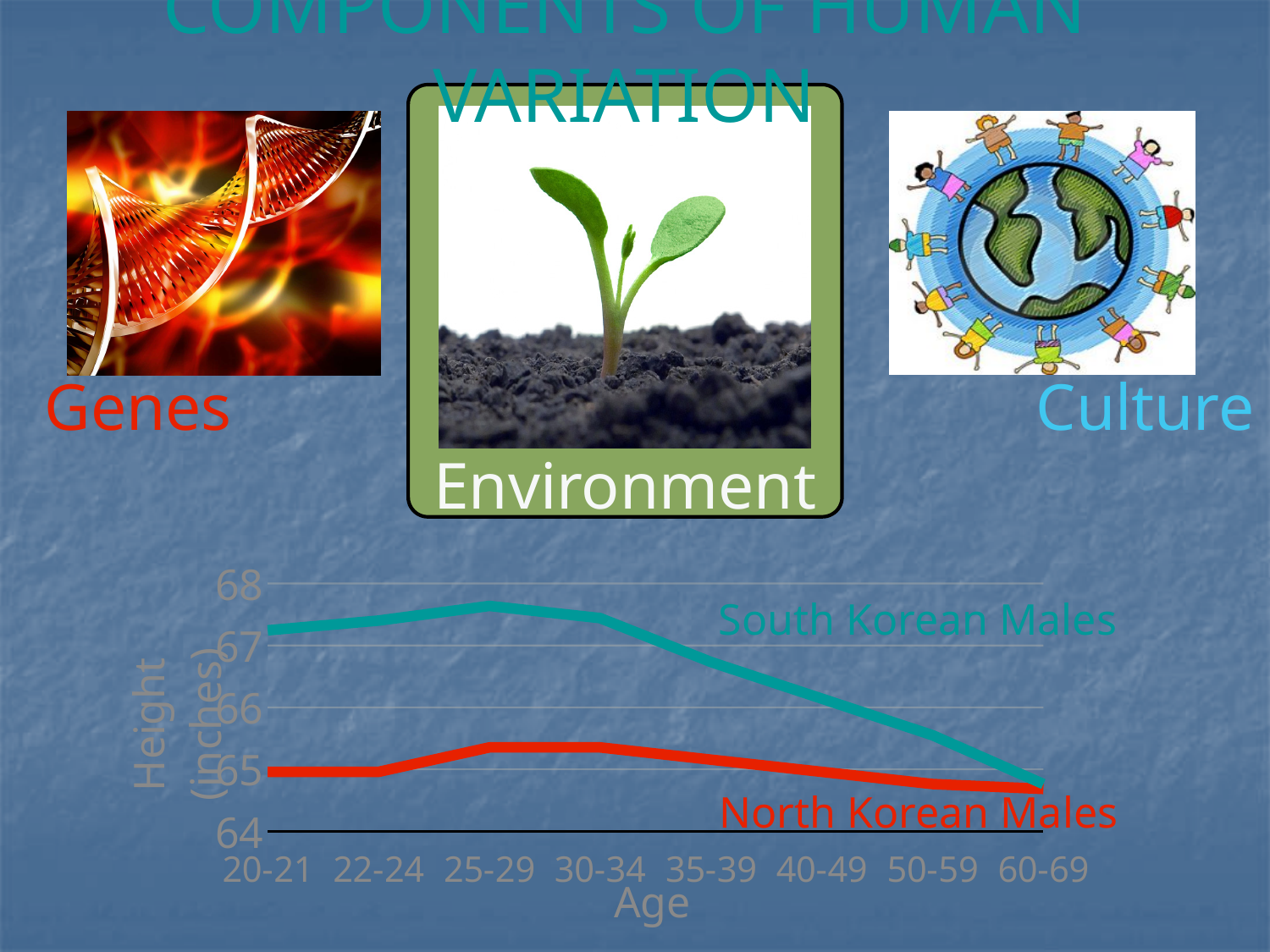
Which age group has the highest height for South Korean Males? 25-29 Is the height of North Korean Males at age 30-34 greater or less than 66 inches? less Is the height of North Korean Males at age 25-29 greater or less than 65 inches? greater Is the height of South Korean Males at age 25-29 greater or less than 67 inches? greater What kind of chart is shown at the bottom of the slide? Line chart Does the height of South Korean Males rise or fall from age 30-34 to age 60-69? Fall How many age groups are shown on the x axis of the height chart? 8 Which age group has the lowest height for South Korean Males? 60-69 How many series are plotted in the height chart? 2 At age 30-34, which group is taller, South Korean Males or North Korean Males? South Korean Males What is the label on the y axis of the height chart? Height (inches)